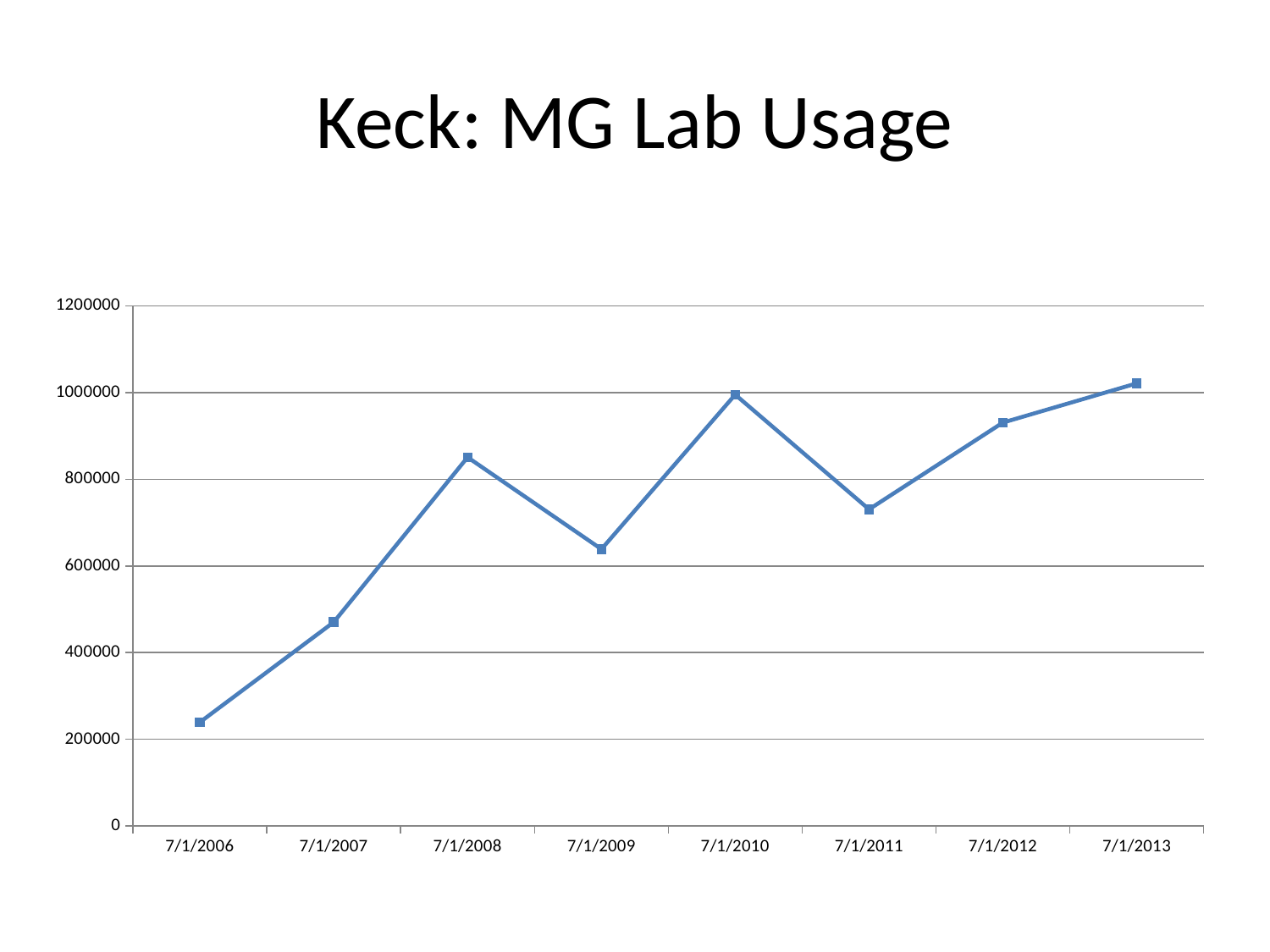
Is the value for 7/1/2011 greater or less than 800000? less Is the value for 7/1/2006 greater or less than 400000? less Is the value for 7/1/2008 greater or less than 800000? greater What is the title of the chart? Keck: MG Lab Usage Which date has the lowest value? 7/1/2006 How many data points are plotted on the line? 8 What kind of chart is shown on the slide? line chart Which is larger, the value for 7/1/2008 or the value for 7/1/2009? 7/1/2008 Which date has the highest value? 7/1/2013 Overall, do the values rise or fall from 7/1/2006 to 7/1/2013? rise